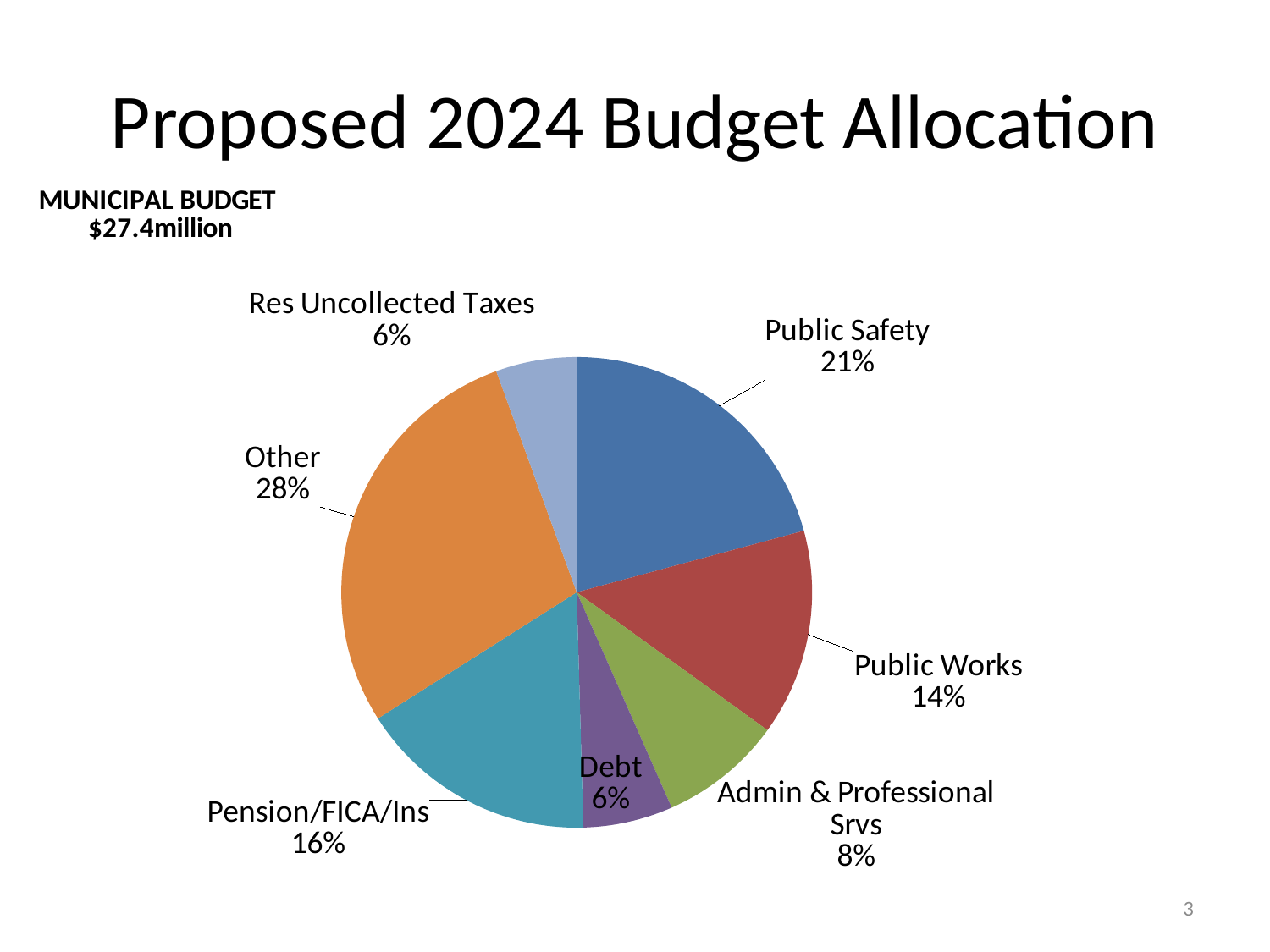
What share of the budget is allocated to Public Works? 14% What is the difference in percentage points between Other and Public Safety? 7 Which category has the largest share of the pie? Other What is the total municipal budget stated on the slide? $27.4million How many categories are shown in the pie chart? 7 What type of chart is shown on the slide? Pie chart What is the title of the slide? Proposed 2024 Budget Allocation What share of the budget is allocated to Pension/FICA/Ins? 16% What share of the budget is allocated to Admin & Professional Srvs? 8% Which category has a larger share, Public Safety or Public Works? Public Safety Which two categories each have a 6% share? Res Uncollected Taxes and Debt